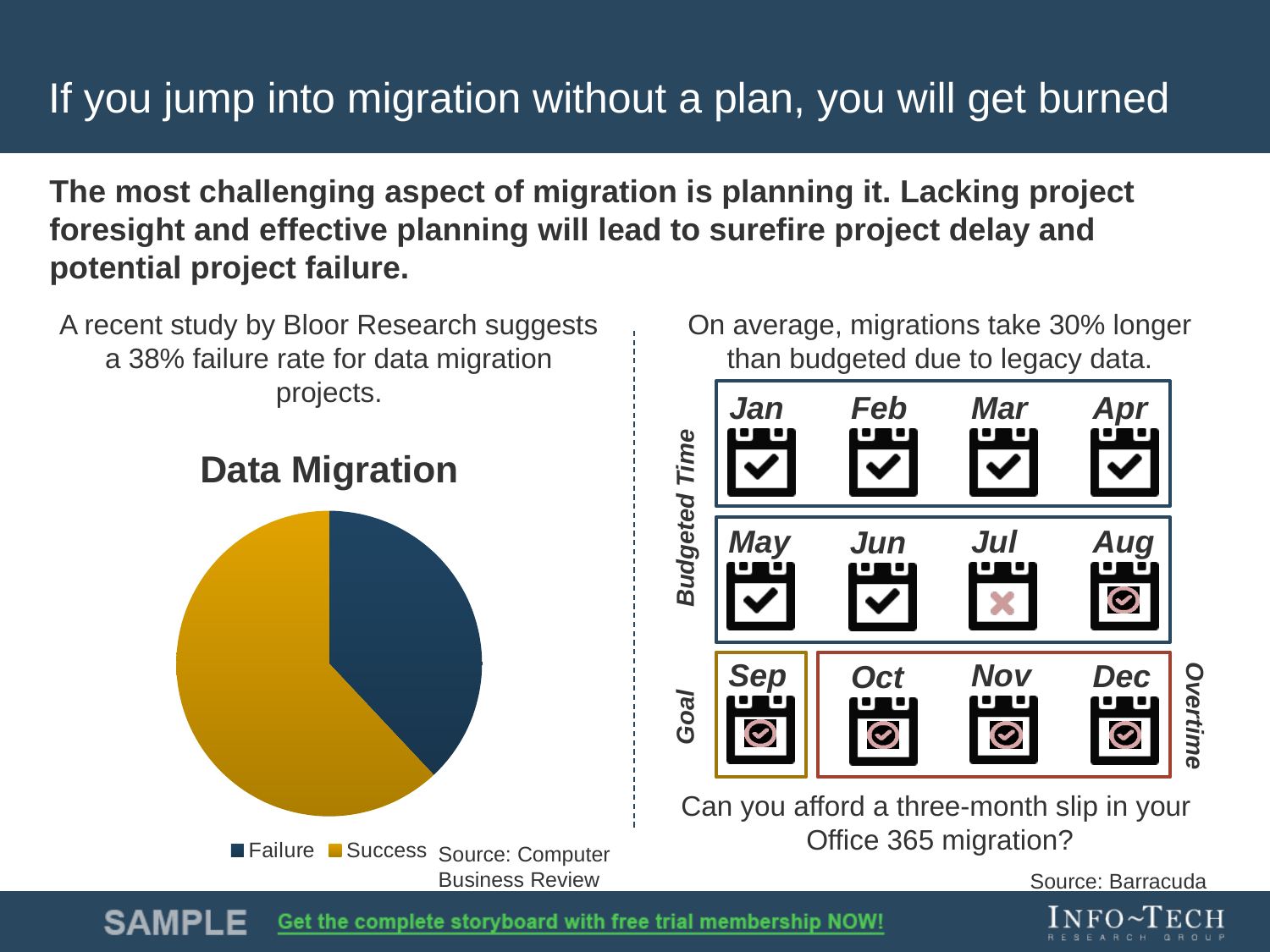
How many slices does the "Data Migration" pie chart have? 2 Which slice of the "Data Migration" pie chart is the largest? Success What kind of chart is the "Data Migration" chart? pie chart How many entries does the legend of the "Data Migration" pie chart list? 2 In the "Data Migration" pie chart, which is larger, the Failure slice or the Success slice? Success What colour represents Failure in the "Data Migration" pie chart? dark blue What is the title of the pie chart on the slide? Data Migration Which slice of the "Data Migration" pie chart is the smallest? Failure